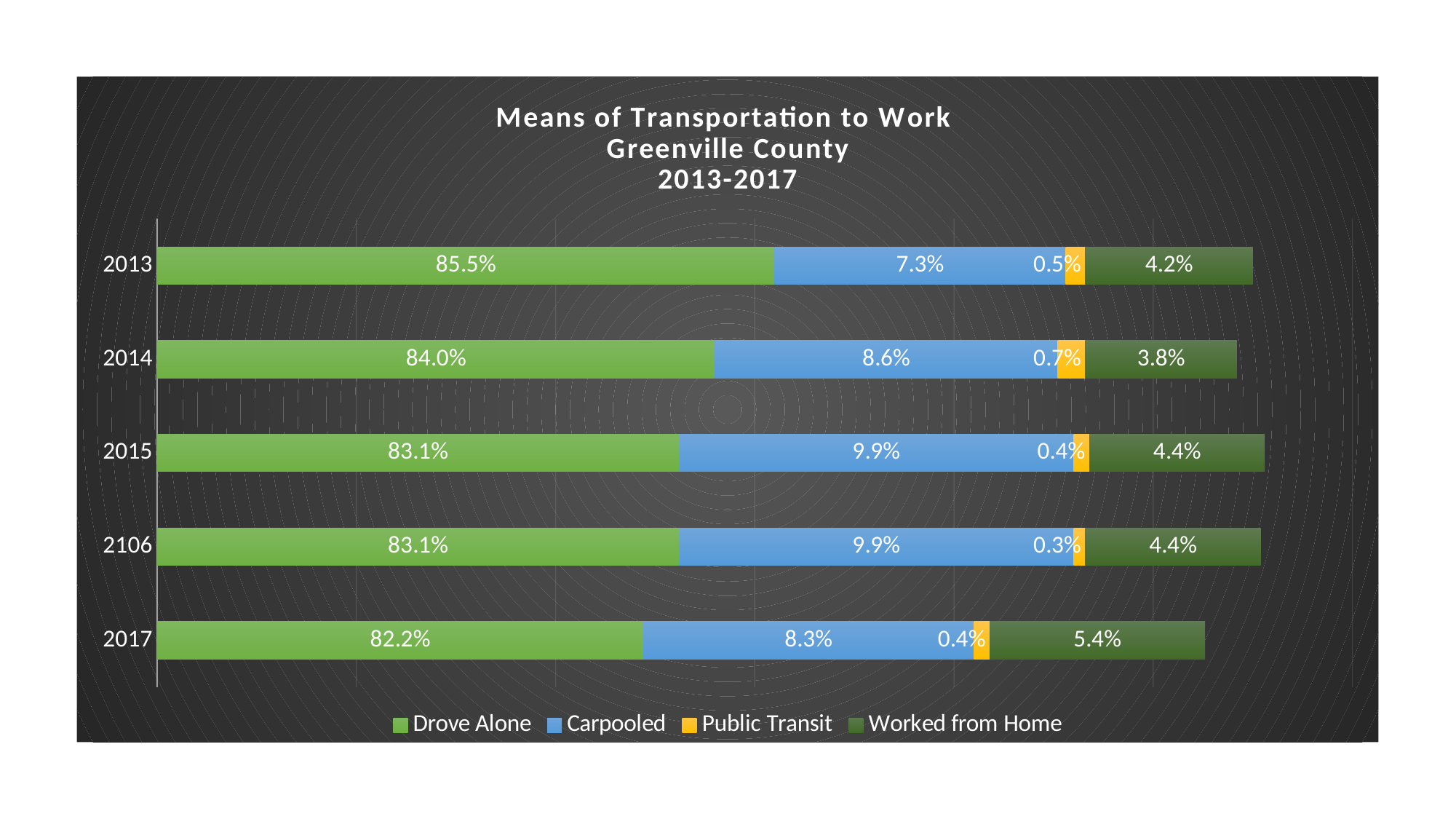
How many years are shown on the chart? 5 What percentage of workers Drove Alone in 2013? 85.5% What is the total of the four labelled segments in the 2017 bar? 96.3% Which year has the lowest Worked from Home percentage? 2014 What is the Worked from Home value for 2017? 5.4% What is the Public Transit value for 2014? 0.7% Which year has the highest Drove Alone percentage? 2013 Which is larger: the Worked from Home value for 2017 or for 2013? 2017 How many series does the legend list? 4 How much higher is the Carpooled value in 2015 than in 2013? 2.6% What kind of chart is this? Stacked bar chart Does the Drove Alone percentage rise or fall from 2013 to 2017? Fall